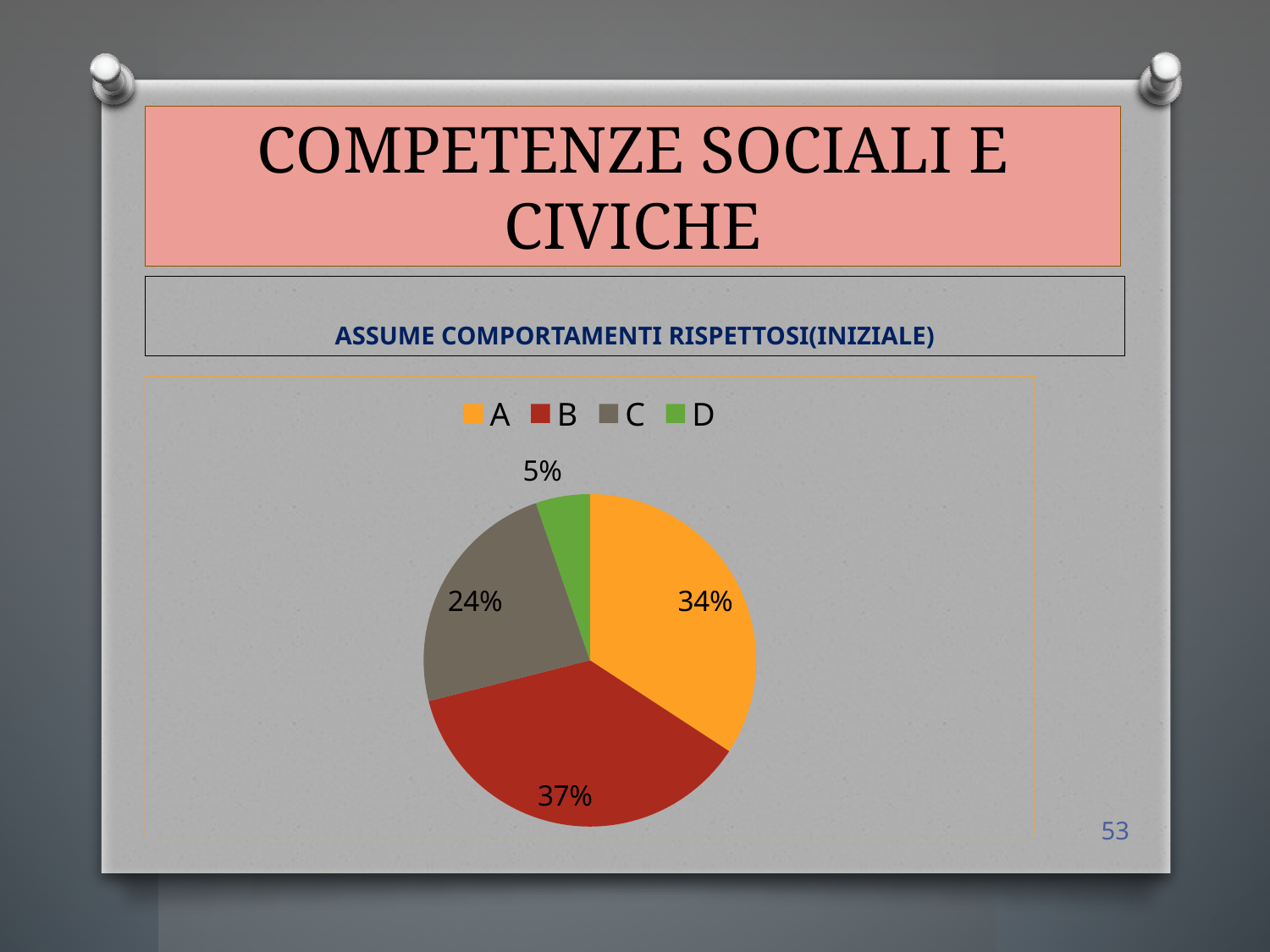
Which is larger, the share for A or the share for C? A What percentage does slice C represent in the pie chart? 24% What is the difference in percentage points between slice B and slice C? 13 Which category has the largest share of the pie chart? B What colour is the slice for category D? green What type of chart is shown on the slide? pie chart What percentage does slice A represent in the pie chart? 34% What percentage does slice D represent in the pie chart? 5% What percentage does slice B represent in the pie chart? 37% Which category has the smallest share of the pie chart? D How many entries does the legend list? 4 How many slices does the pie chart have? 4